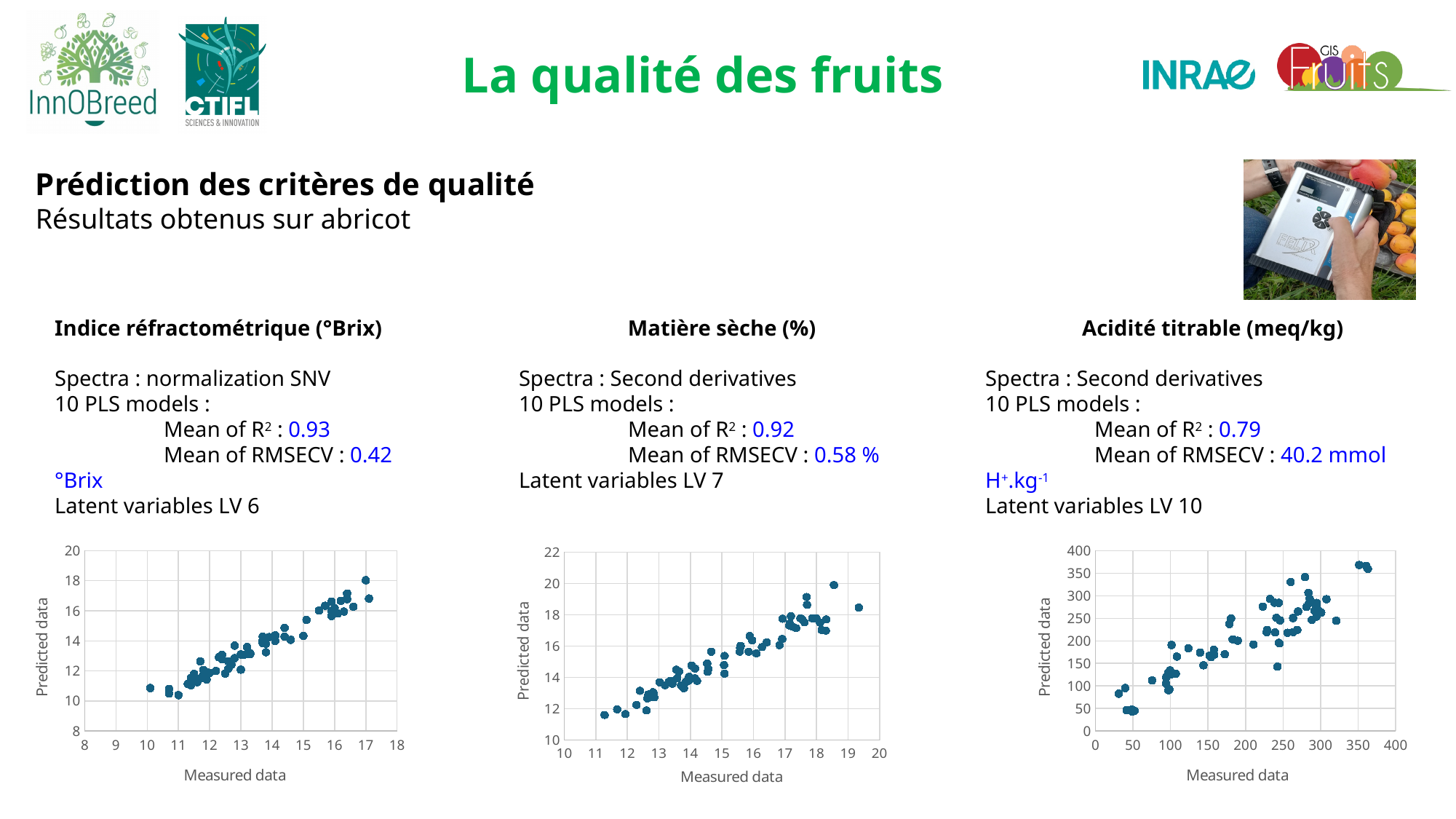
In the 'Indice réfractométrique (°Brix)' chart, is the highest predicted value greater or less than 16? greater What is the x-axis label of the 'Matière sèche (%)' chart? Measured data What kind of chart is the 'Indice réfractométrique (°Brix)' chart? scatter chart In the 'Matière sèche (%)' chart, is the lowest predicted value greater or less than 12? less In the 'Acidité titrable (meq/kg)' chart, do the predicted values rise or fall as the measured data increases? rise What is the y-axis label of the 'Acidité titrable (meq/kg)' chart? Predicted data In the 'Acidité titrable (meq/kg)' chart, is the lowest predicted value greater or less than 100? less In the 'Matière sèche (%)' chart, do the predicted values rise or fall as the measured data increases? rise How many scatter charts are shown on the slide? 3